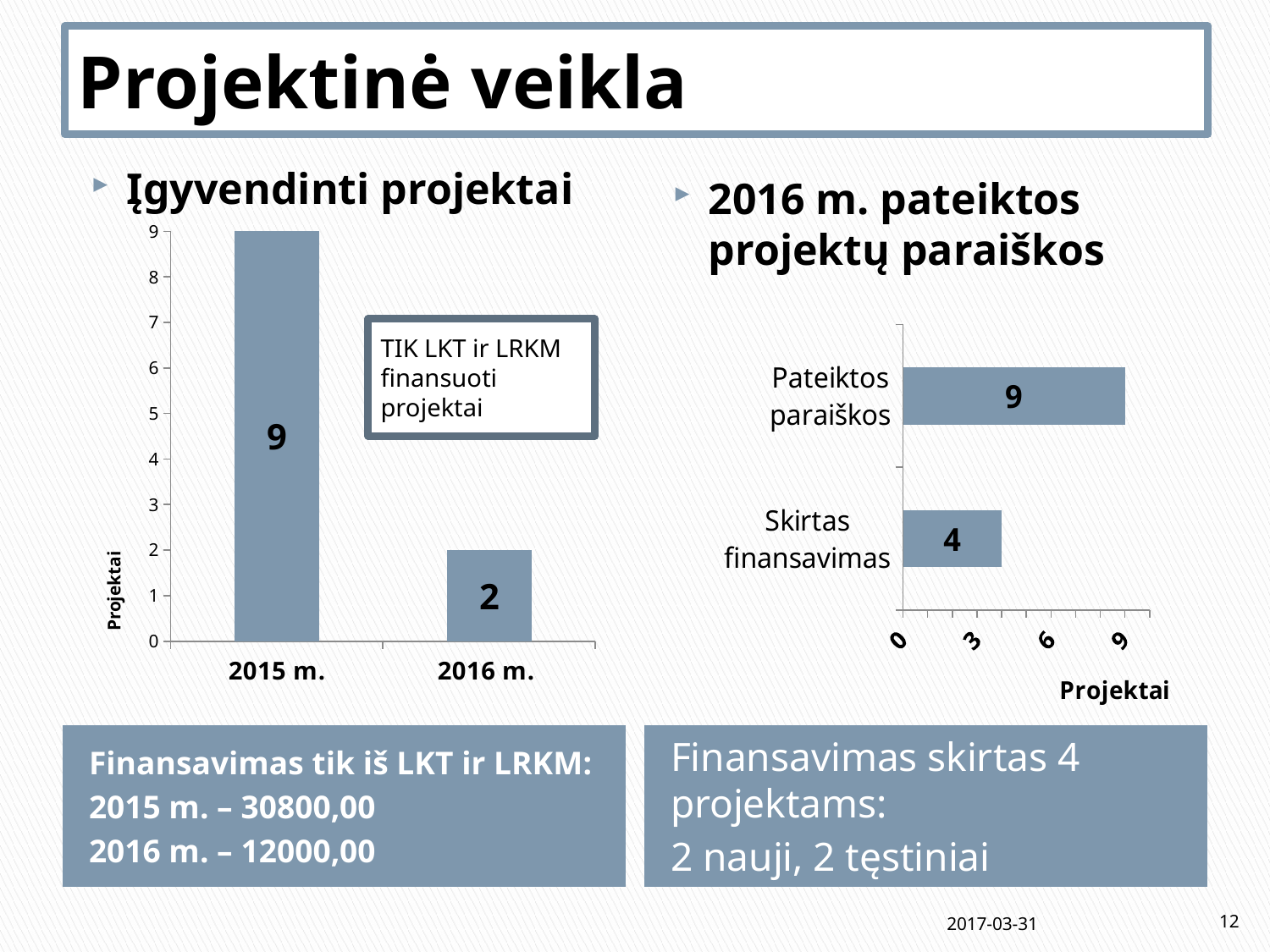
In the right chart (2016 m. pateiktos projektų paraiškos), which category has the lowest value? Skirtas finansavimas What kind of chart is the left chart (Įgyvendinti projektai)? Bar chart In the right chart (2016 m. pateiktos projektų paraiškos), what is the value for Pateiktos paraiškos? 9 What is the label of the horizontal axis in the right chart (2016 m. pateiktos projektų paraiškos)? Projektai In the left chart (Įgyvendinti projektai), what is the value for 2015 m.? 9 In the left chart (Įgyvendinti projektai), how many categories are shown on the x axis? 2 In the left chart (Įgyvendinti projektai), do the values rise or fall from 2015 m. to 2016 m.? Fall In the right chart (2016 m. pateiktos projektų paraiškos), what is the difference between Pateiktos paraiškos and Skirtas finansavimas? 5 In the left chart (Įgyvendinti projektai), which year has the higher value? 2015 m. In the left chart (Įgyvendinti projektai), what is the value for 2016 m.? 2 In the left chart (Įgyvendinti projektai), what is the difference between the values for 2015 m. and 2016 m.? 7 In the right chart (2016 m. pateiktos projektų paraiškos), what is the value for Skirtas finansavimas? 4